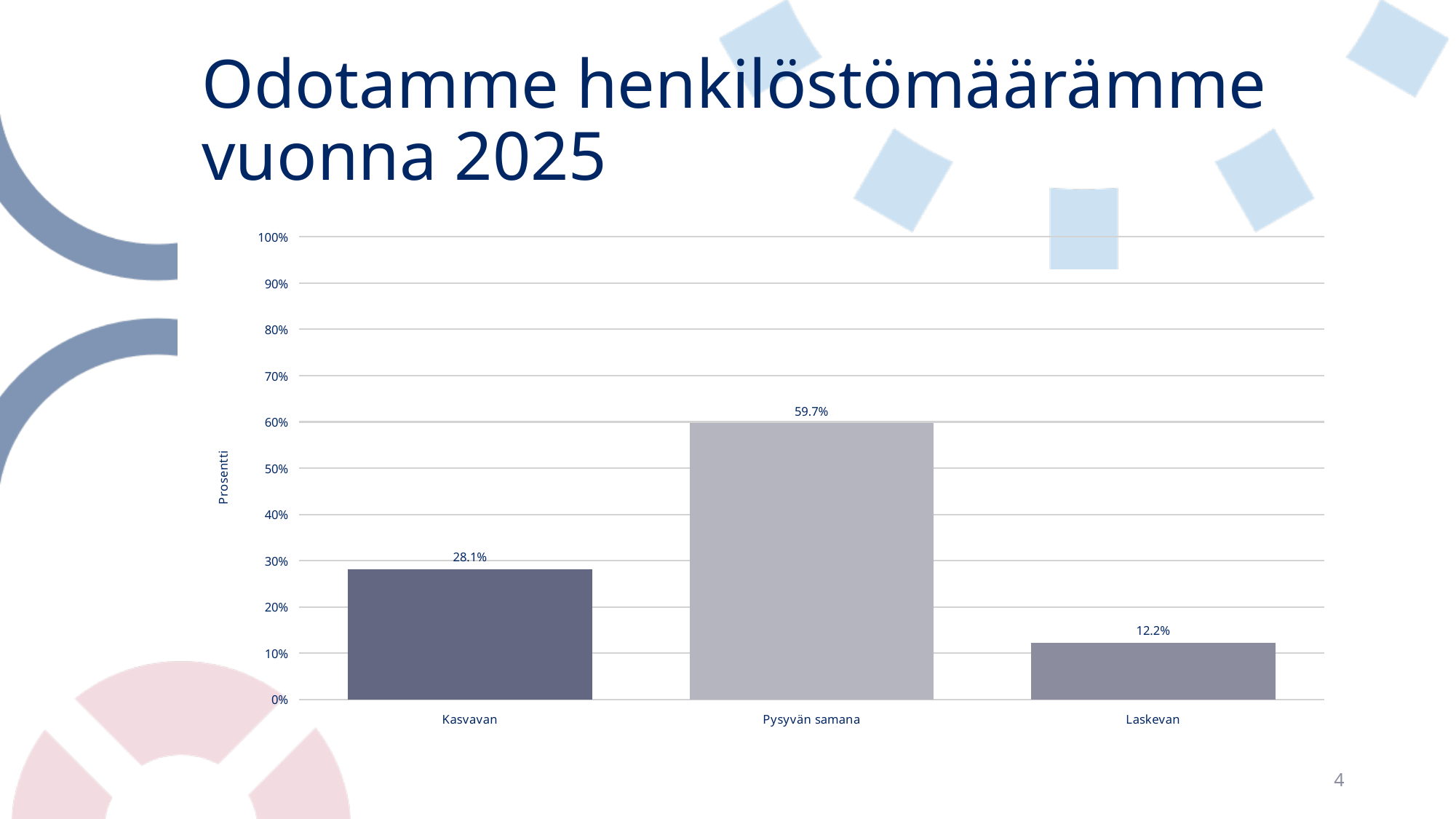
What is the value for Pysyvän samana? 59.7% Which category has the highest value? Pysyvän samana How many categories are shown on the x axis? 3 Is the value for Pysyvän samana greater or less than 50%? greater What is the difference between the values for Pysyvän samana and Kasvavan? 31.6% What is the label of the vertical axis? Prosentti Which is larger, the value for Kasvavan or the value for Laskevan? Kasvavan What is the difference between the values for Kasvavan and Laskevan? 15.9% What kind of chart is shown on the slide? bar chart What is the value for Kasvavan? 28.1% What is the value for Laskevan? 12.2% Which category has the lowest value? Laskevan